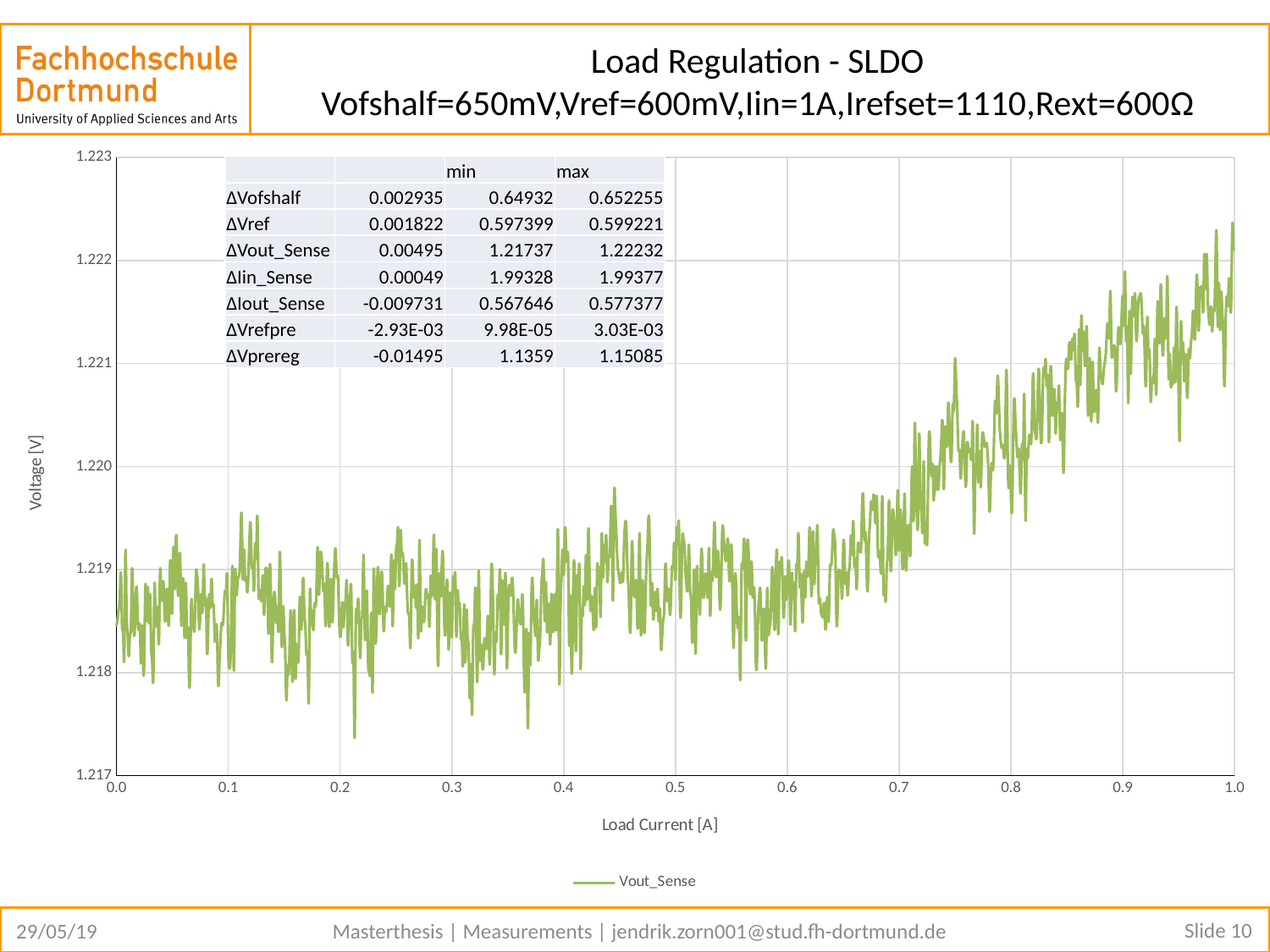
In the table on the chart, what is the max value listed for ΔIin_Sense? 1.99377 In the table on the chart, which row has the lowest value in the first numeric column? ΔVprereg At a load current of 0.2 A, is the Vout_Sense value greater or less than 1.220 V? less What kind of chart is shown on the slide? line chart In the table on the chart, what is the max value listed for ΔVout_Sense? 1.22232 What is the label of the vertical axis of the chart? Voltage [V] What is the name of the series shown in the chart legend? Vout_Sense In the table on the chart, what is the min value listed for ΔVout_Sense? 1.21737 In the table on the chart, what is the value in the first numeric column for ΔVref? 0.001822 At a load current of 0.9 A, is the Vout_Sense value greater or less than 1.220 V? greater How many series does the chart legend list? 1 Does the Vout_Sense voltage overall rise or fall as the load current increases from 0.0 A to 1.0 A? rise